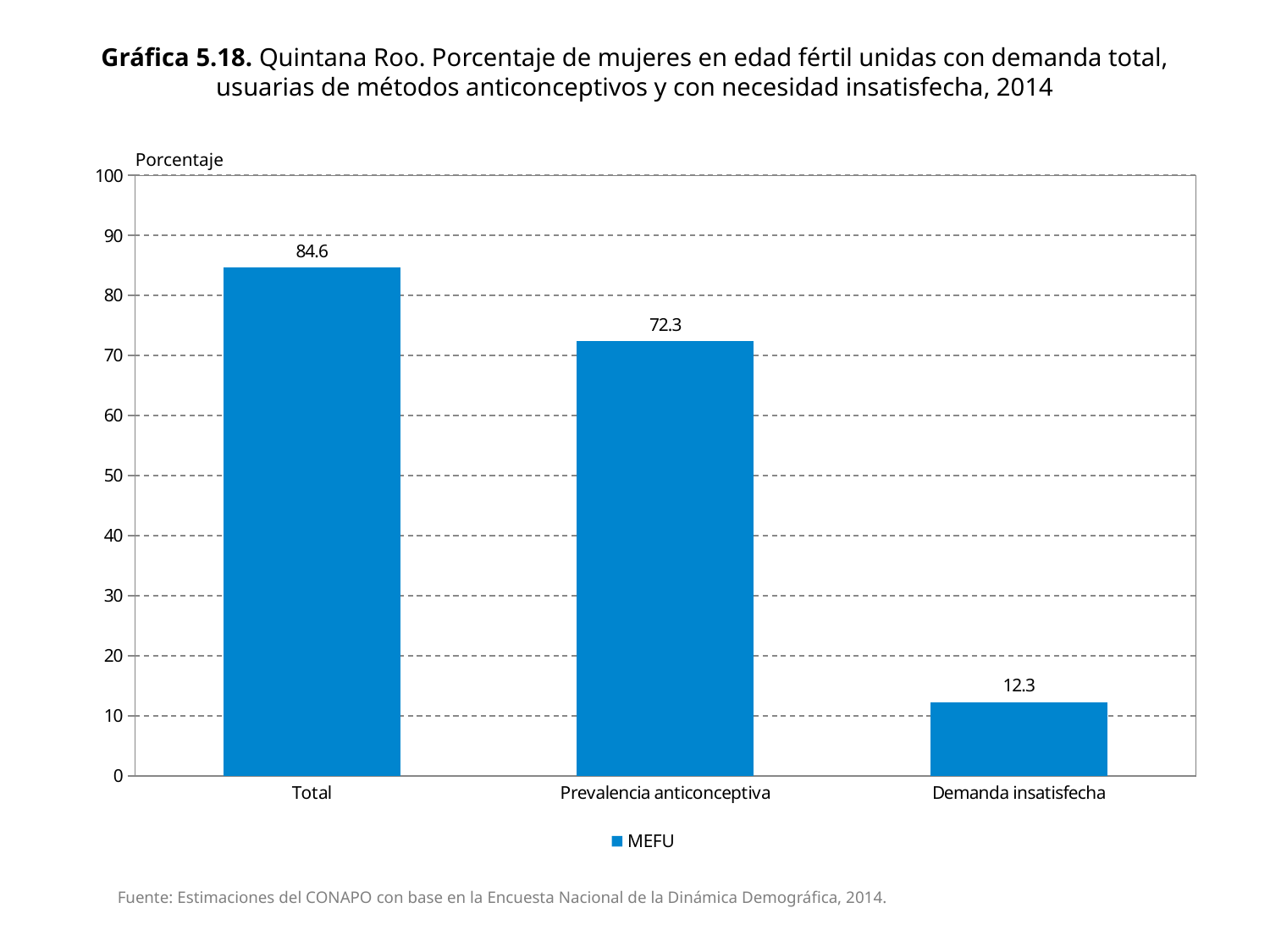
What is the value for Total? 84.6 What is the value for Demanda insatisfecha? 12.3 Which category has the lowest value? Demanda insatisfecha What series name does the legend show? MEFU What is the difference between the values for Prevalencia anticonceptiva and Demanda insatisfecha? 60 Which is larger, the value for Prevalencia anticonceptiva or the value for Demanda insatisfecha? Prevalencia anticonceptiva Which category has the highest value? Total Is the value for Demanda insatisfecha greater or less than 20? less What kind of chart is shown on the slide? bar chart What is the difference between the values for Total and Prevalencia anticonceptiva? 12.3 What is the value for Prevalencia anticonceptiva? 72.3 How many categories are shown on the x axis? 3